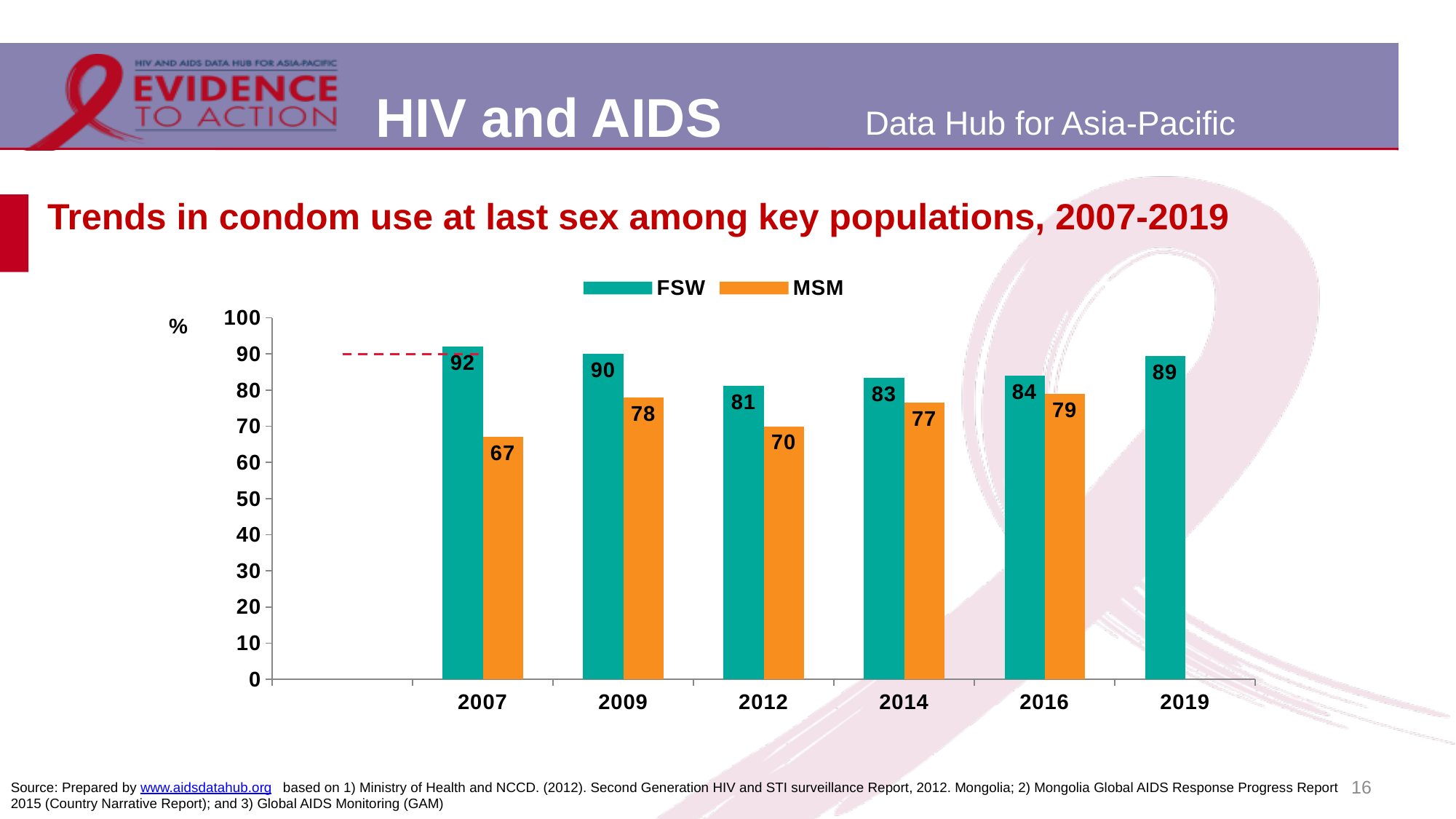
In which year is the MSM value lowest? 2007 What kind of chart is shown on the slide? Bar chart Which is larger in 2016, the FSW value or the MSM value? FSW What is the MSM value for 2012? 70 What is the title of the chart? Trends in condom use at last sex among key populations, 2007-2019 What is the FSW value for 2007? 92 In which year is the FSW value highest? 2007 What is the difference between the FSW and MSM values in 2007? 25 How many series does the legend list? 2 What is the FSW value for 2019? 89 Does the MSM value rise or fall from 2007 to 2016? Rise How many years are shown on the x axis? 6